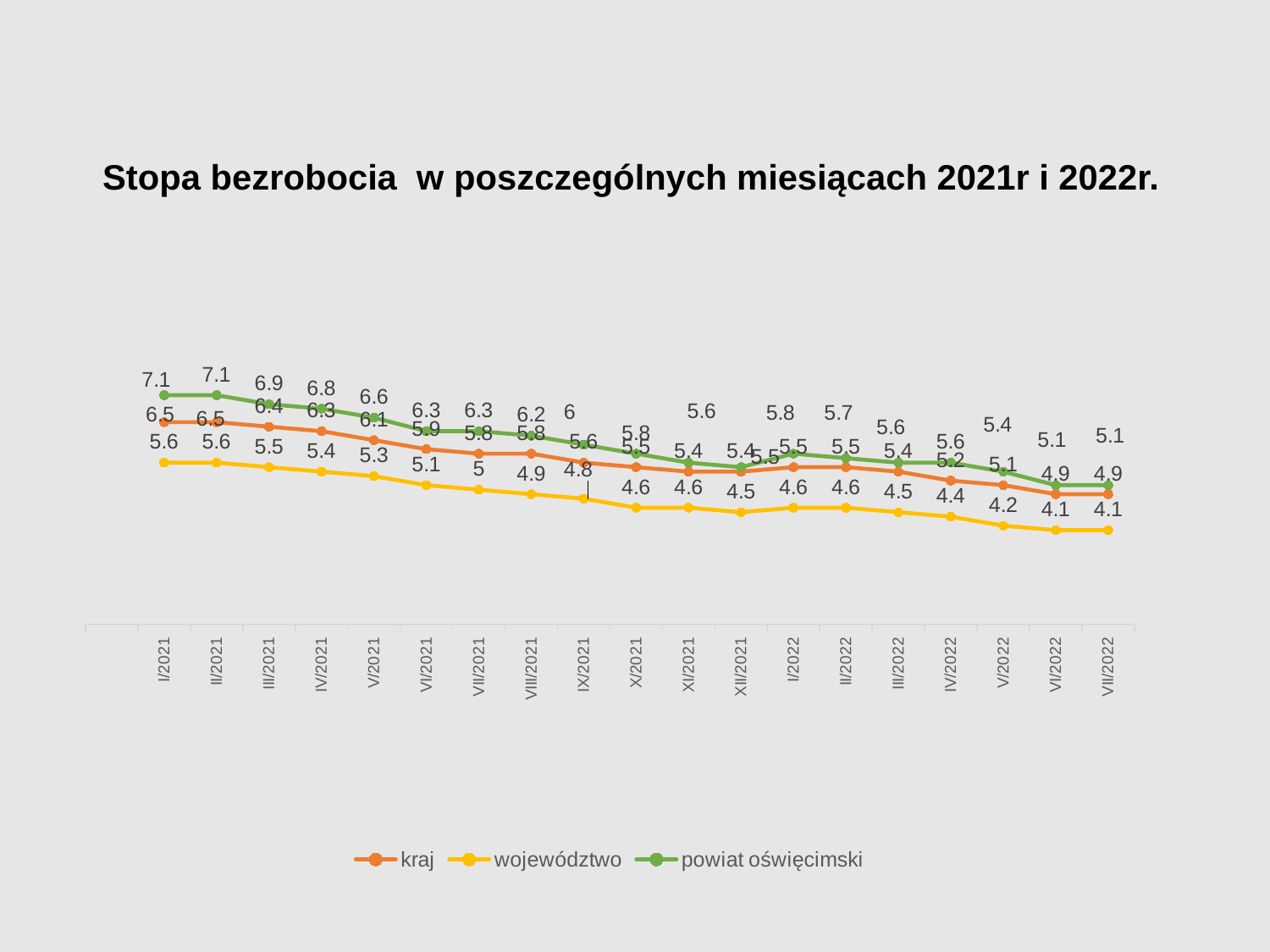
What is the value for województwo in VII/2022? 4.1 What is the value for województwo in V/2022? 4.2 Is the value for kraj larger in I/2021 or in VII/2022? I/2021 What is the value for powiat oświęcimski in I/2022? 5.8 What is the value for powiat oświęcimski in I/2021? 7.1 What is the value for kraj in I/2021? 6.5 Do the values for województwo generally rise or fall from I/2021 to VII/2022? fall Which series has the highest value in I/2021? powiat oświęcimski What kind of chart is shown on the slide? line chart How many series does the legend list? 3 What is the difference between powiat oświęcimski and województwo in I/2021? 1.5 How many months (categories) are plotted along the x axis? 19